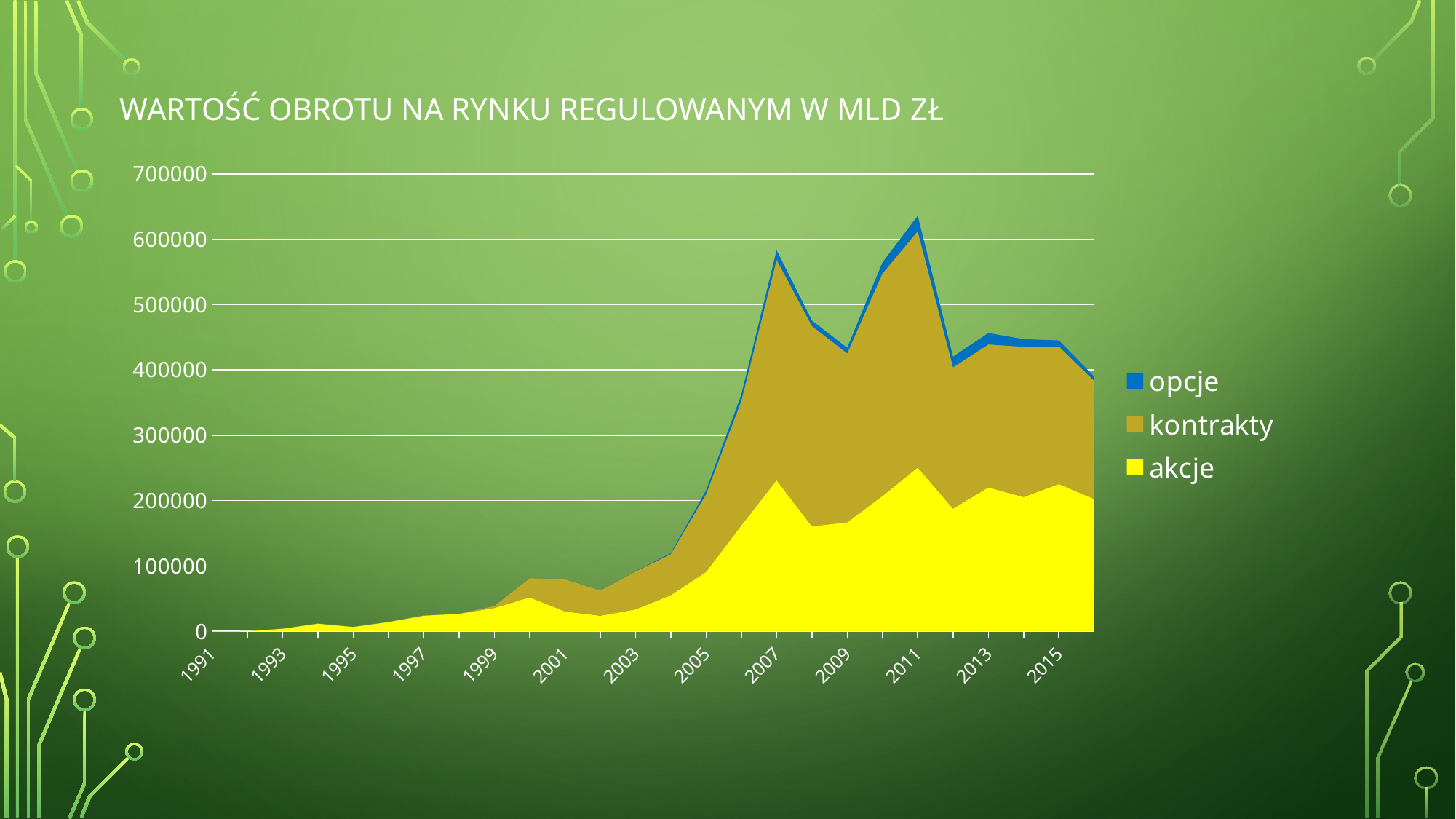
Is the total value for 2011 greater or less than 600000? greater Is the value for akcje in 2011 greater or less than 200000? greater Is the value for akcje in 2009 greater or less than 200000? less Which year has the larger total value, 2007 or 2011? 2011 What is the title of the chart? WARTOŚĆ OBROTU NA RYNKU REGULOWANYM W MLD ZŁ How many series does the legend list? 3 Does the total value rise or fall between 1991 and 2007? rise Which series is shown in yellow? akcje What kind of chart is shown on the slide? Stacked area chart In which year does the total value reach its highest point? 2011